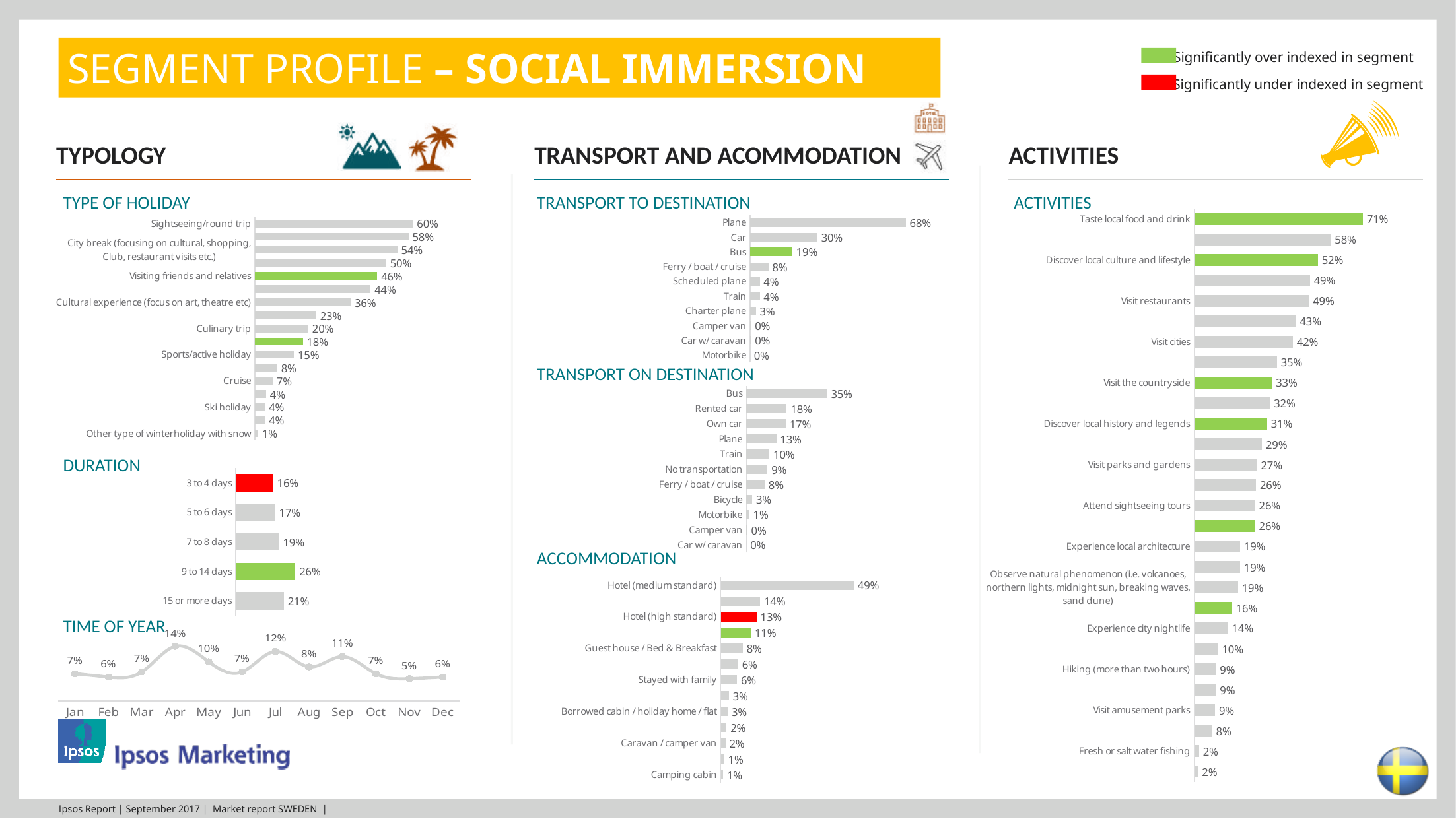
What kind of chart is the Time of Year chart? Line chart In the Activities chart, what is the value for Taste local food and drink? 71% In the Transport to Destination chart, what is the value for Plane? 68% In the Transport on Destination chart, which is larger, Rented car or Own car? Rented car In the Activities chart, what is the difference between Visit restaurants and Visit cities? 7% In the Type of Holiday chart, what is the difference between Sightseeing/round trip and Visiting friends and relatives? 14% In the Duration chart, which duration has the lowest value? 3 to 4 days In the Time of Year chart, which month has the highest value? Apr In the Accommodation chart, what is the value for Hotel (high standard)? 13% How many categories are shown in the Transport to Destination chart? 10 In the Duration chart, which duration has the highest value? 9 to 14 days In the Time of Year chart, what is the value for Nov? 5%